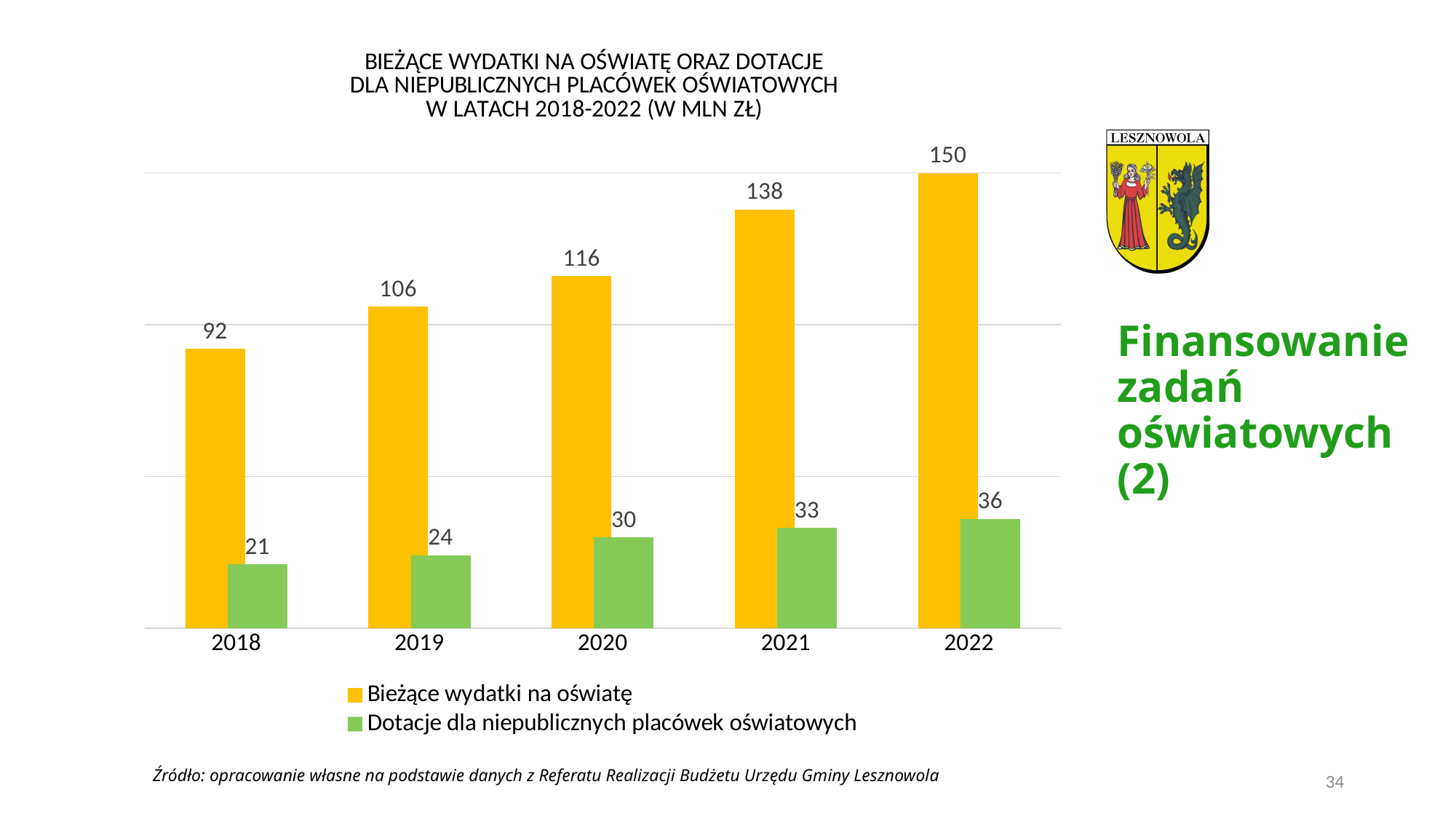
What is the difference between Bieżące wydatki na oświatę in 2022 and in 2018? 58 What colour are the bars for Dotacje dla niepublicznych placówek oświatowych? Green How many series does the legend list? 2 What kind of chart is shown on the slide? Bar chart Which is larger: Dotacje dla niepublicznych placówek oświatowych in 2020 or in 2022? 2022 How many years are shown on the x axis? 5 What is the value of Dotacje dla niepublicznych placówek oświatowych in 2019? 24 In which year is Bieżące wydatki na oświatę highest? 2022 Do the values of Bieżące wydatki na oświatę rise or fall from 2018 to 2022? Rise What is the difference between Bieżące wydatki na oświatę and Dotacje dla niepublicznych placówek oświatowych in 2021? 105 In which year is Dotacje dla niepublicznych placówek oświatowych lowest? 2018 What is the value of Bieżące wydatki na oświatę in 2020? 116